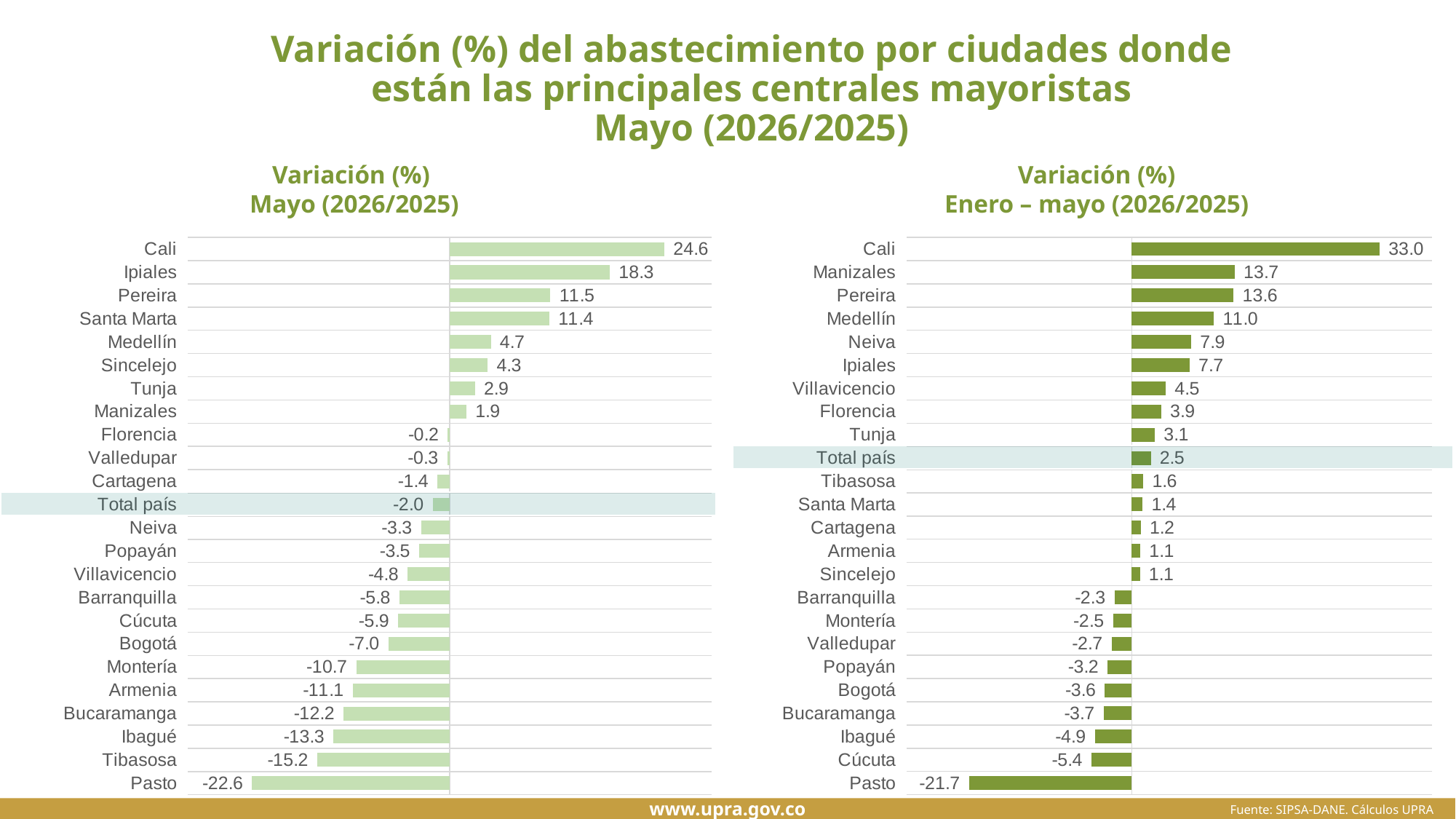
In the left chart (Variación (%) Mayo (2026/2025)), what is the value for Total país? -2.0 In the right chart (Variación (%) Enero – mayo (2026/2025)), which is larger, the value for Neiva or the value for Villavicencio? Neiva In the left chart (Variación (%) Mayo (2026/2025)), which is larger, the value for Medellín or the value for Sincelejo? Medellín In the left chart (Variación (%) Mayo (2026/2025)), which city has the lowest value? Pasto In the right chart (Variación (%) Enero – mayo (2026/2025)), what is the value for Cali? 33.0 In the left chart (Variación (%) Mayo (2026/2025)), what is the difference between the values for Cali and Ipiales? 6.3 In the right chart (Variación (%) Enero – mayo (2026/2025)), which city has the highest value? Cali In the left chart (Variación (%) Mayo (2026/2025)), how many categories are plotted? 24 What kind of chart is the right chart (Variación (%) Enero – mayo (2026/2025))? Bar chart In the right chart (Variación (%) Enero – mayo (2026/2025)), what is the difference between the values for Manizales and Medellín? 2.7 In the right chart (Variación (%) Enero – mayo (2026/2025)), what is the value for Total país? 2.5 In the left chart (Variación (%) Mayo (2026/2025)), what is the value for Cali? 24.6